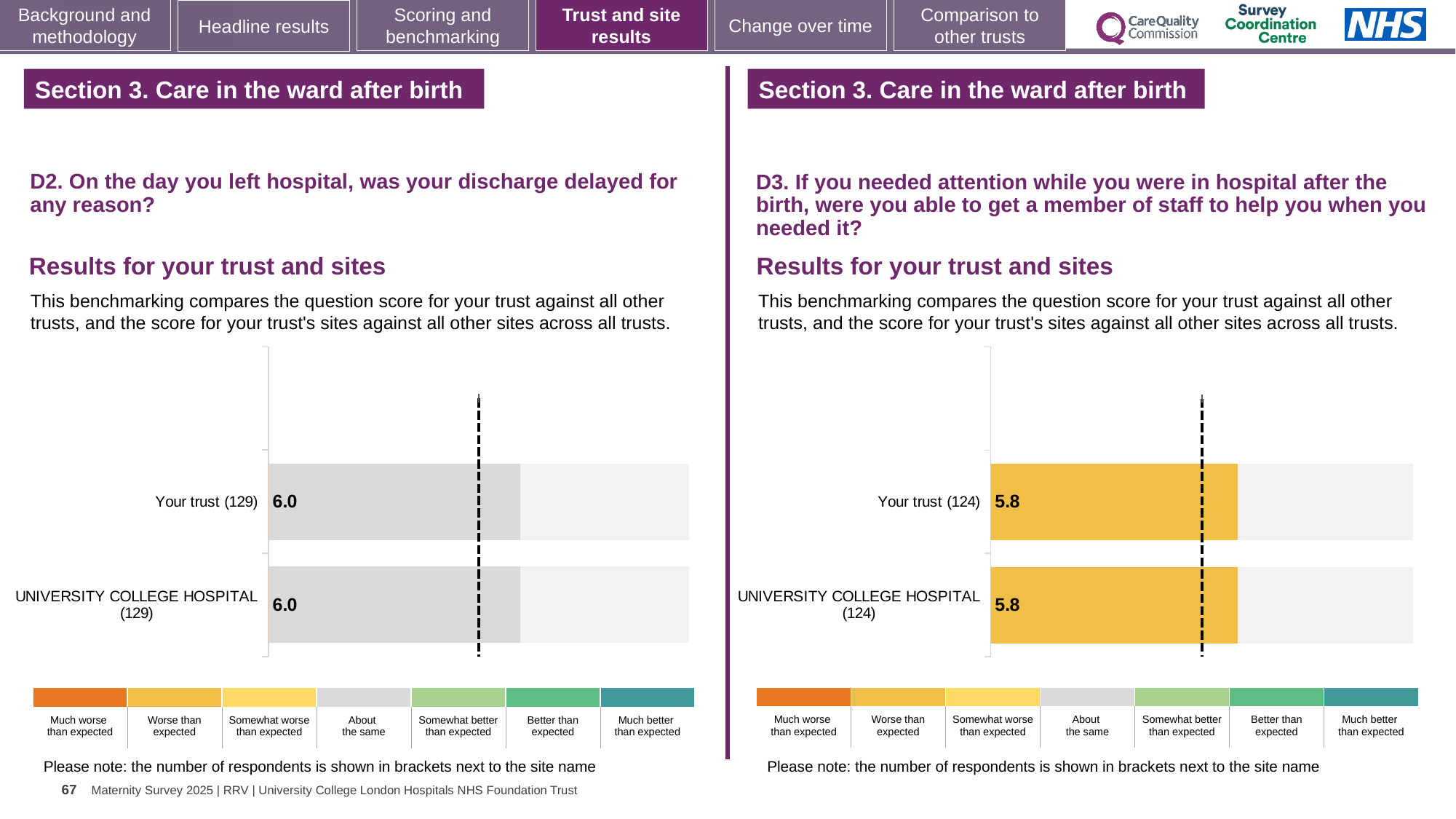
How many bars are plotted in the D2 chart on the left? 2 In the D3 chart on the right, which benchmarking category does the colour of the bars correspond to according to the key? Worse than expected What type of chart is used in the D3 chart on the right? Bar chart In the D2 chart on the left, what is the difference between the score for Your trust and the score for UNIVERSITY COLLEGE HOSPITAL? 0.0 In the D2 chart on the left, how many respondents are shown in brackets for Your trust? 129 In the D2 chart on the left, what is the score for UNIVERSITY COLLEGE HOSPITAL (129)? 6.0 How many bars are plotted in the D3 chart on the right? 2 In the D2 chart on the left, what is the score for Your trust (129)? 6.0 In the D2 chart on the left, which benchmarking category does the colour of the bars correspond to according to the key? About the same In the D3 chart on the right, what is the difference between the score for Your trust and the score for UNIVERSITY COLLEGE HOSPITAL? 0.0 In the D3 chart on the right, what is the score for Your trust (124)? 5.8 In the D3 chart on the right, what is the score for UNIVERSITY COLLEGE HOSPITAL (124)? 5.8